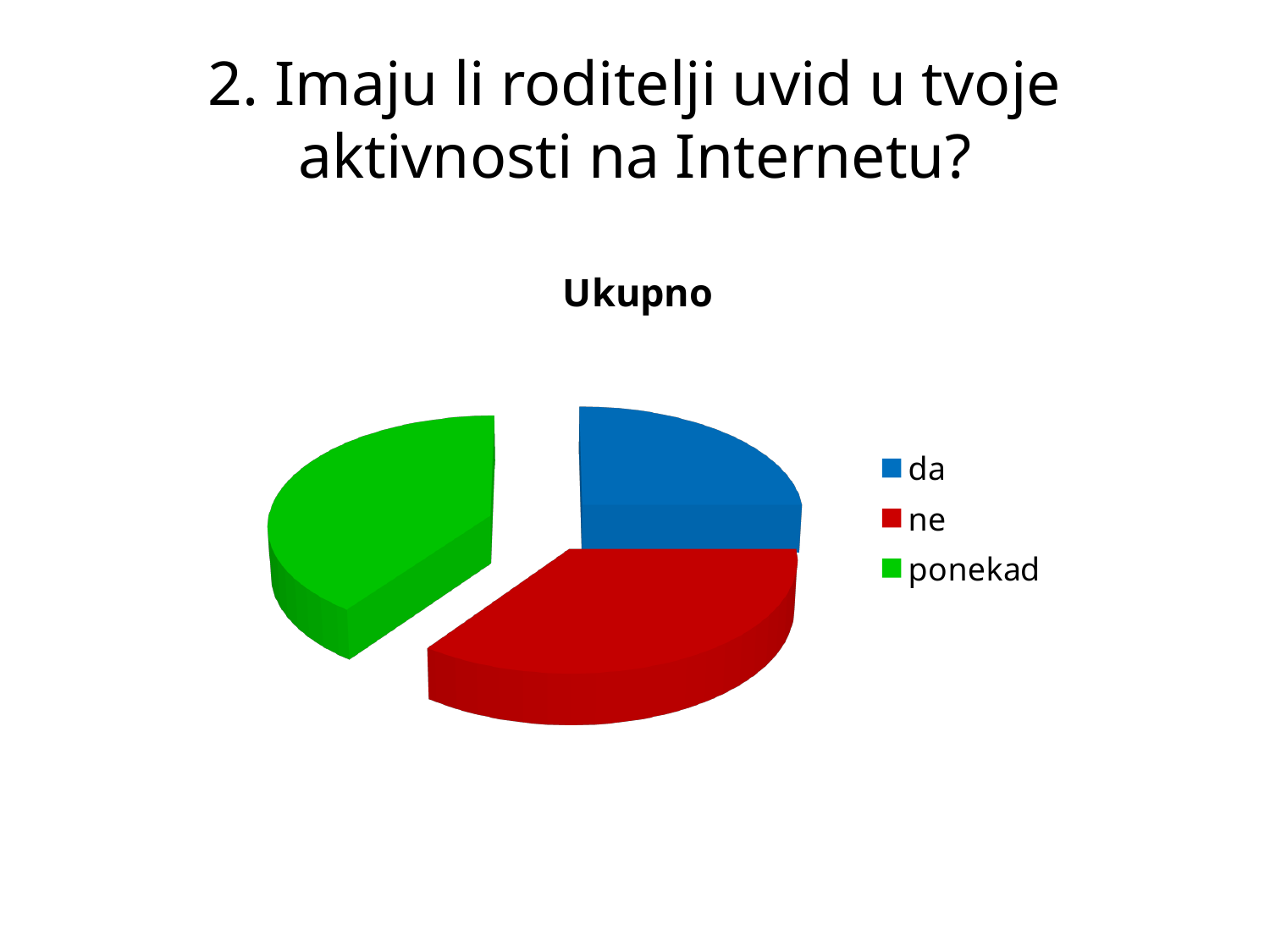
How many entries does the legend of the pie chart list? 3 What kind of chart is shown on the slide? pie chart How many slices does the pie chart have? 3 Which slice is larger, "ne" or "da"? ne Which slice is larger, "ponekad" or "da"? ponekad What colour is the "ponekad" slice in the pie chart? green What is the title of the pie chart? Ukupno Which category has the smallest slice in the pie chart? da